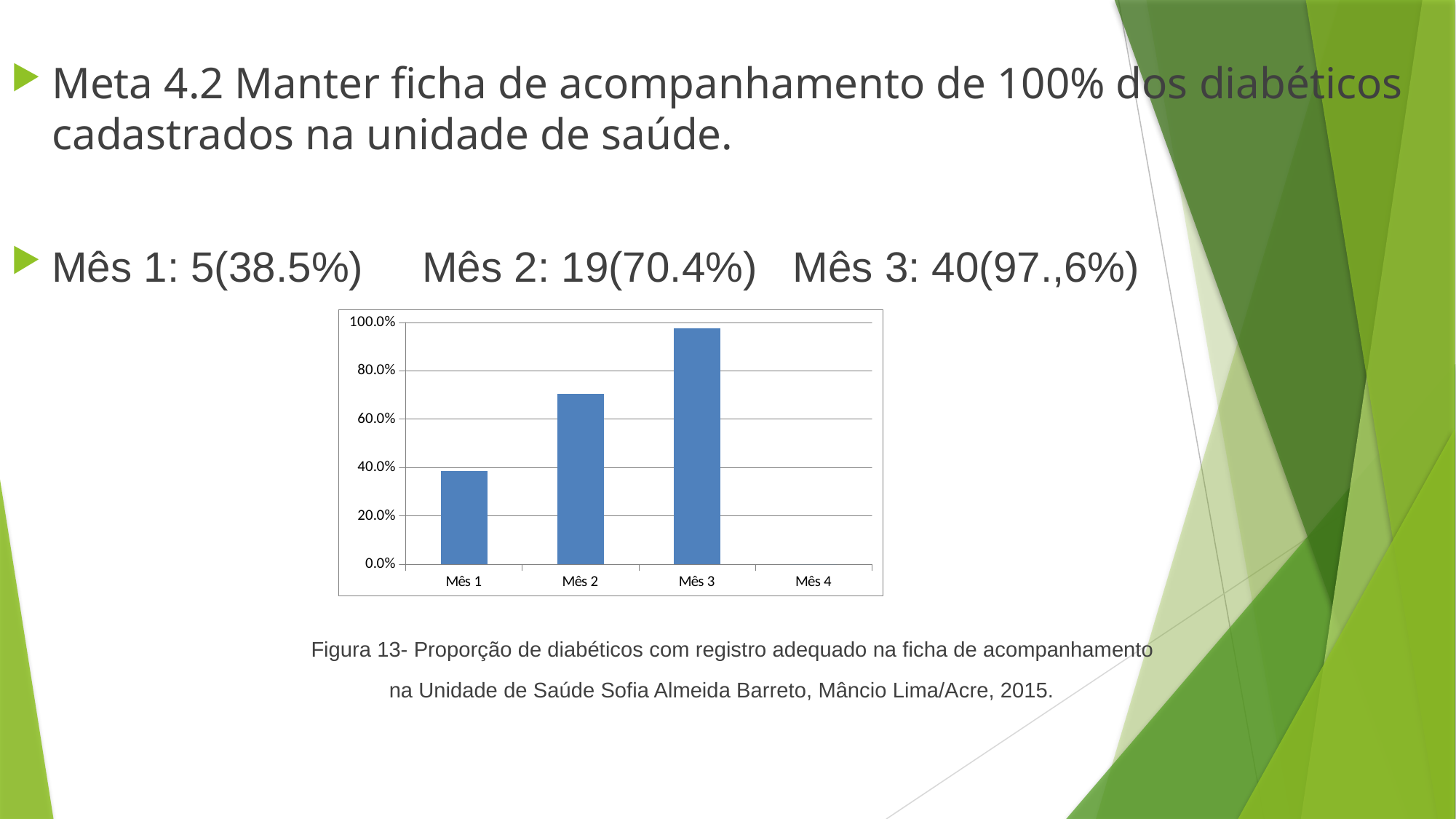
How many month categories are shown on the x axis of the chart? 4 Is the value for Mês 1 greater or less than 40.0%? less Which month has the tallest bar in the chart? Mês 3 According to the slide text, what is the proportion for Mês 2? 70.4% Is the value for Mês 3 greater or less than 80.0%? greater According to the slide text, what is the proportion for Mês 1? 38.5% Which is larger, the value for Mês 1 or the value for Mês 2? Mês 2 Which month category on the x axis has no bar plotted? Mês 4 Is the value for Mês 2 greater or less than 60.0%? greater What is the highest tick value shown on the y axis of the chart? 100.0% What kind of chart is shown on the slide? bar chart Do the values rise or fall from Mês 1 to Mês 3? rise